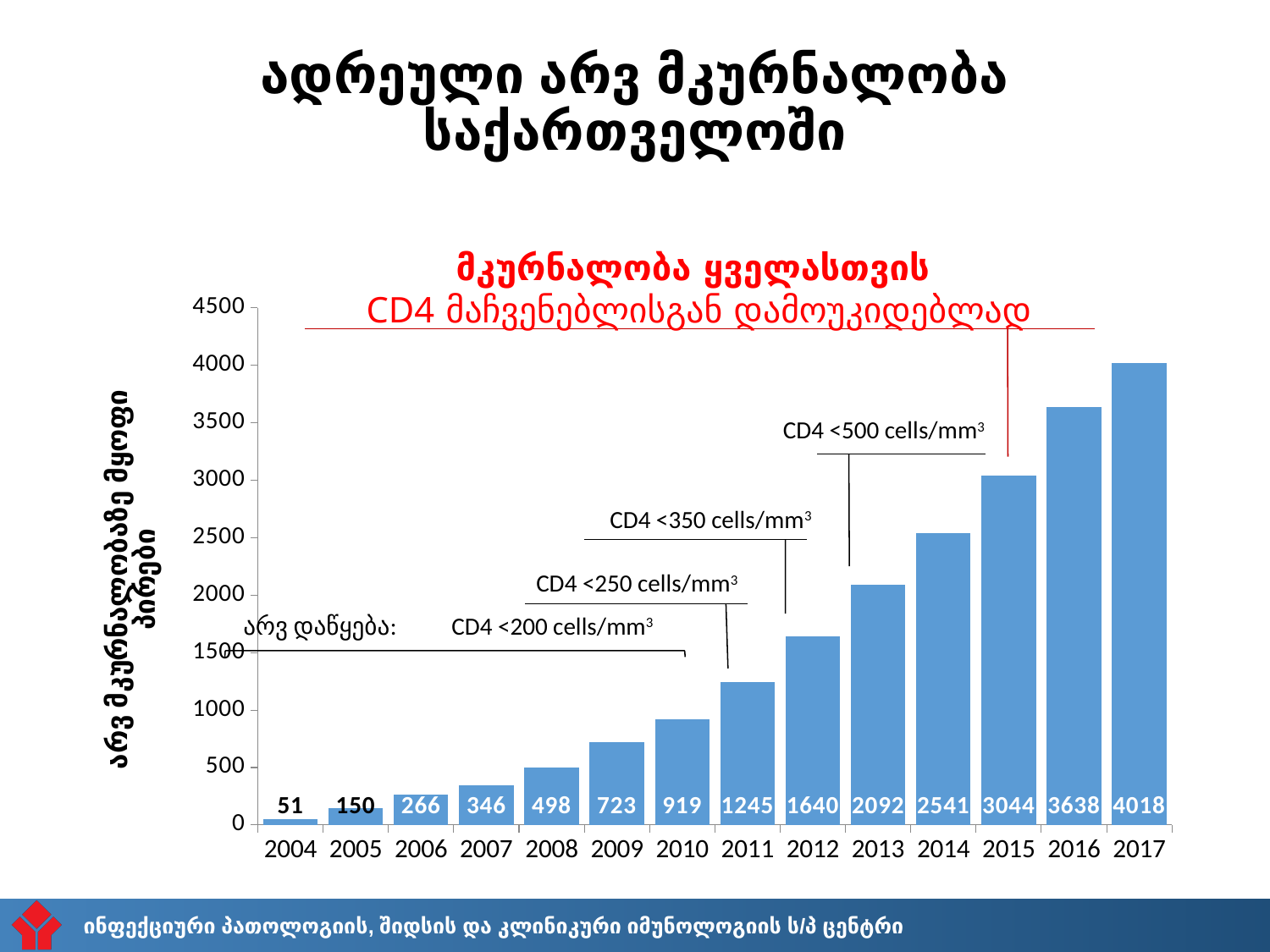
What is the difference between the values for 2017 and 2016? 380 Which is larger, the value for 2013 or the value for 2014? 2014 Which year has the lowest value? 2004 What is the value for 2011? 1245 What is the highest tick value shown on the y axis? 4500 Which year has the highest value? 2017 What is the value for 2017? 4018 What type of chart is shown on the slide? bar chart What is the value for 2004? 51 How many years are shown on the x axis of the chart? 14 What is the difference between the values for 2012 and 2011? 395 Do the values rise or fall from 2004 to 2017? rise